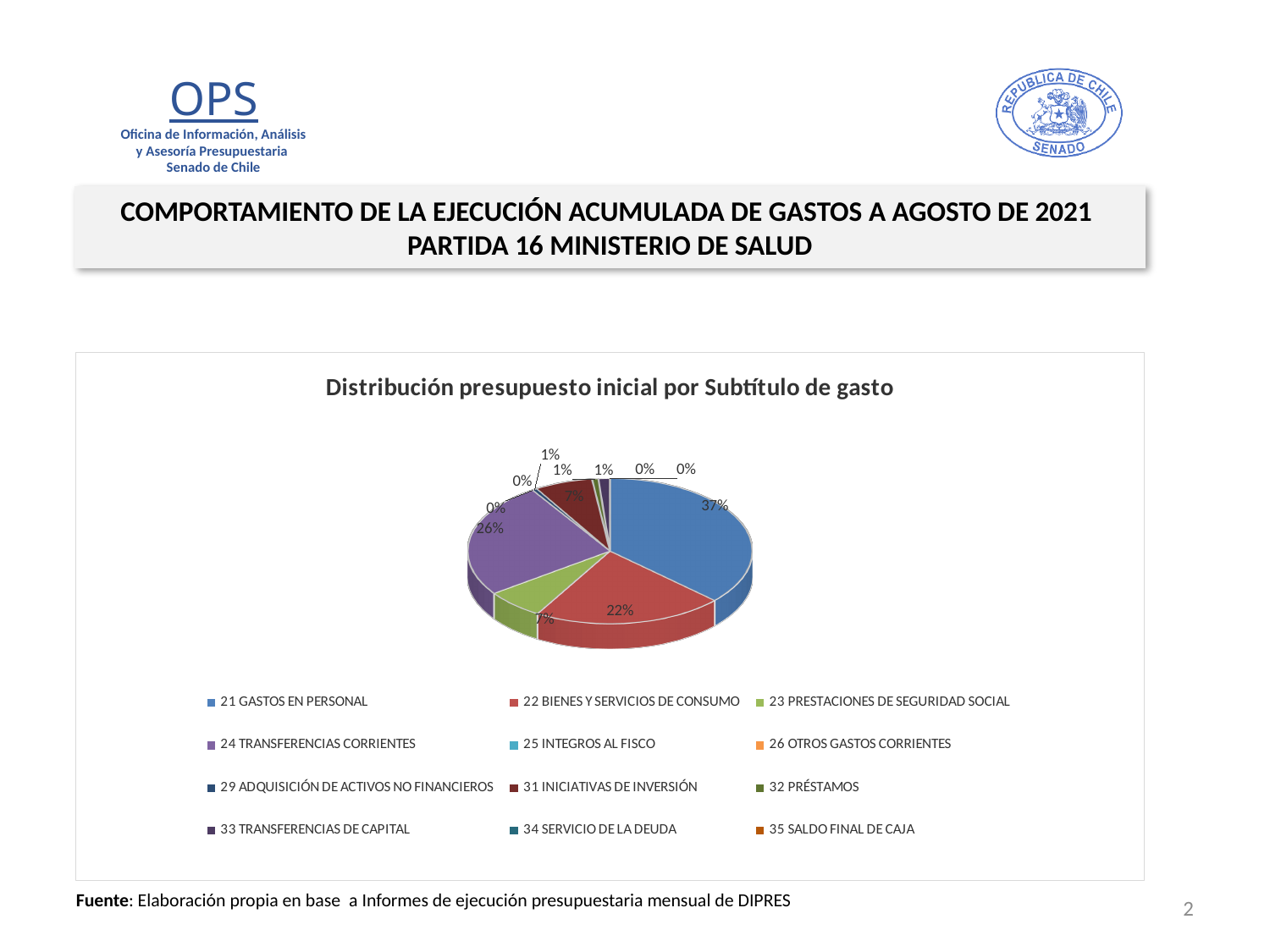
What is the title of the chart? Distribución presupuesto inicial por Subtítulo de gasto Which category has the largest share of the pie? 21 GASTOS EN PERSONAL What is the difference in percentage points between the share for 21 GASTOS EN PERSONAL and the share for 22 BIENES Y SERVICIOS DE CONSUMO? 15 percentage points Which is larger, the share for 22 BIENES Y SERVICIOS DE CONSUMO or the share for 24 TRANSFERENCIAS CORRIENTES? 24 TRANSFERENCIAS CORRIENTES How many categories does the chart's legend list? 12 What colour is the slice for 21 GASTOS EN PERSONAL? Blue What kind of chart is shown on the slide? Pie chart What share of the pie does 31 INICIATIVAS DE INVERSIÓN represent? 7% What share of the pie does 21 GASTOS EN PERSONAL represent? 37% What share of the pie does 23 PRESTACIONES DE SEGURIDAD SOCIAL represent? 7%